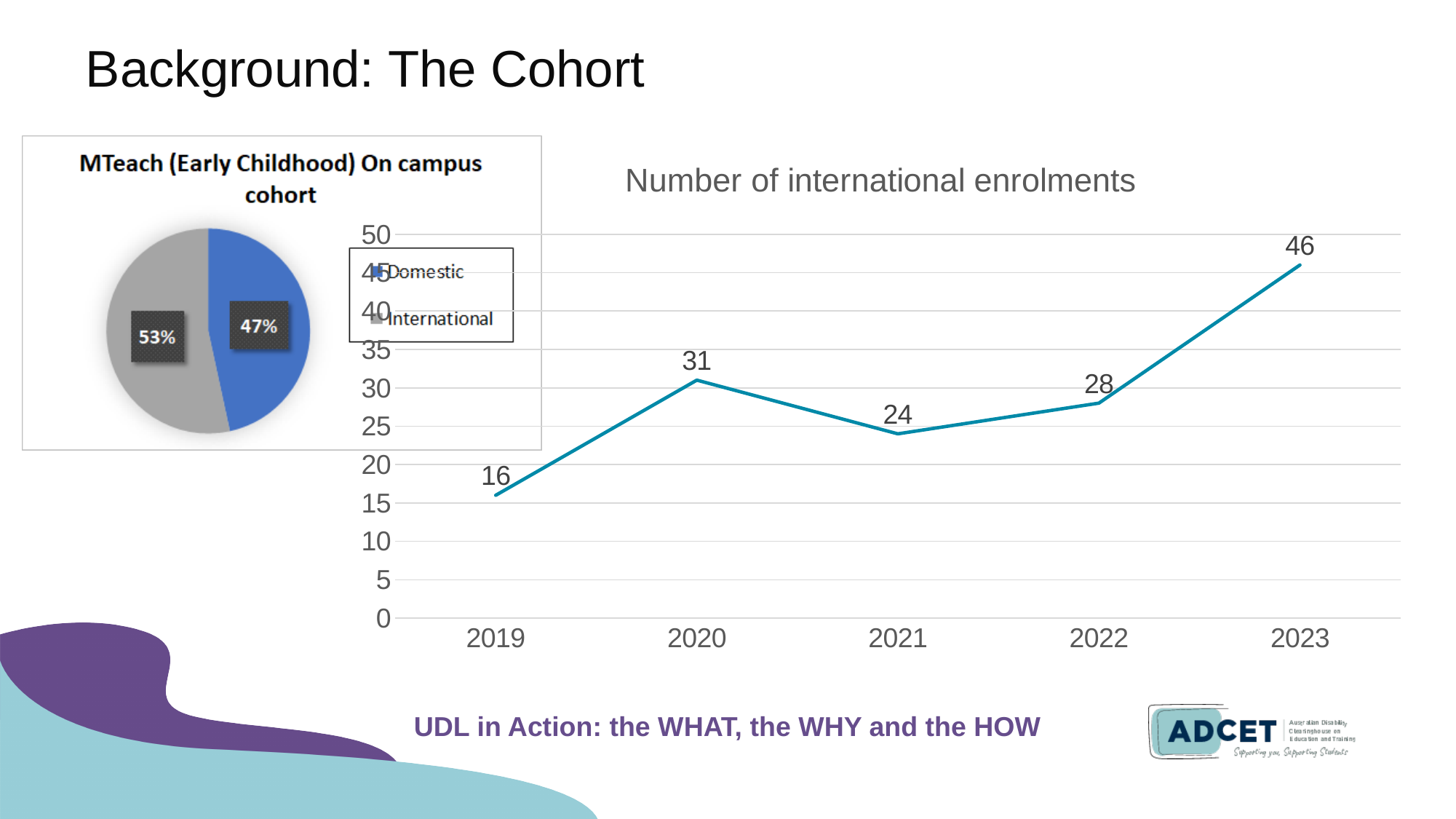
In the 'Number of international enrolments' chart, which year had more enrolments, 2020 or 2021? 2020 In the 'MTeach (Early Childhood) On campus cohort' pie chart, what share is International? 53% In the 'Number of international enrolments' chart, how many years are plotted? 5 In the 'MTeach (Early Childhood) On campus cohort' pie chart, what share is Domestic? 47% In the 'Number of international enrolments' chart, which year had the lowest number of enrolments? 2019 In the 'Number of international enrolments' chart, what was the value for 2019? 16 In the 'Number of international enrolments' chart, what was the value for 2021? 24 What kind of chart is the 'Number of international enrolments' chart? Line chart In the 'Number of international enrolments' chart, which year had the highest number of enrolments? 2023 In the 'Number of international enrolments' chart, did the value rise or fall from 2020 to 2021? Fall In the 'MTeach (Early Childhood) On campus cohort' pie chart, how many categories does the legend list? 2 In the 'Number of international enrolments' chart, what is the difference between the 2023 and 2022 values? 18